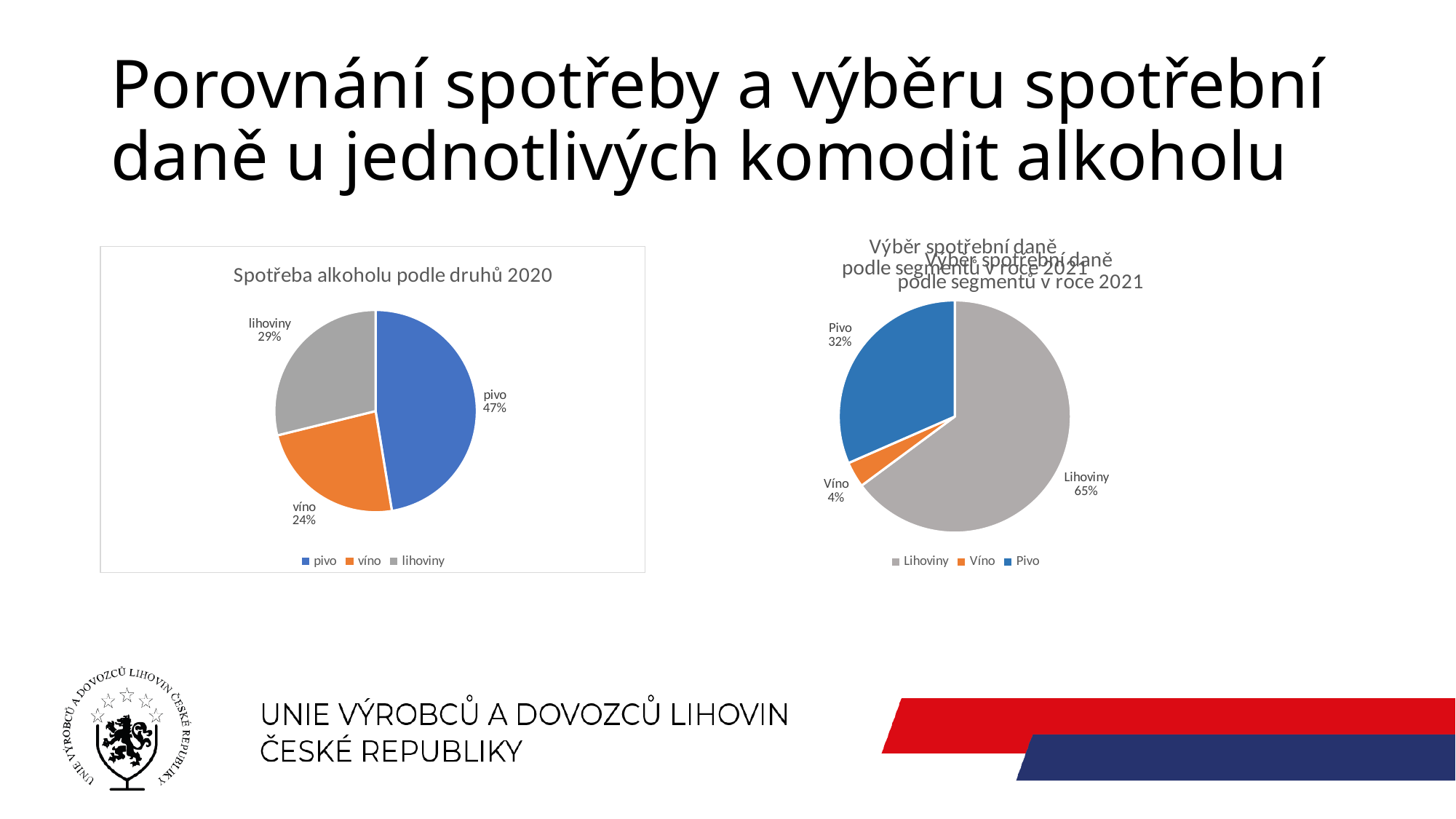
In the right chart 'Výběr spotřební daně podle segmentů v roce 2021', what is the difference in percentage points between Lihoviny and Pivo? 33 How many slices does the left chart 'Spotřeba alkoholu podle druhů 2020' have? 3 What type of chart is the right chart 'Výběr spotřební daně podle segmentů v roce 2021'? pie chart In the right chart 'Výběr spotřební daně podle segmentů v roce 2021', which segment has the largest slice? Lihoviny In the left chart 'Spotřeba alkoholu podle druhů 2020', what is the difference in percentage points between pivo and lihoviny? 18 In the left chart 'Spotřeba alkoholu podle druhů 2020', what share does víno have? 24% In the left chart 'Spotřeba alkoholu podle druhů 2020', what share does pivo have? 47% In the right chart 'Výběr spotřební daně podle segmentů v roce 2021', what share does Víno have? 4% In the right chart 'Výběr spotřební daně podle segmentů v roce 2021', which is larger, Pivo or Víno? Pivo In the left chart 'Spotřeba alkoholu podle druhů 2020', which category has the largest slice? pivo In the left chart 'Spotřeba alkoholu podle druhů 2020', which category has the smallest slice? víno